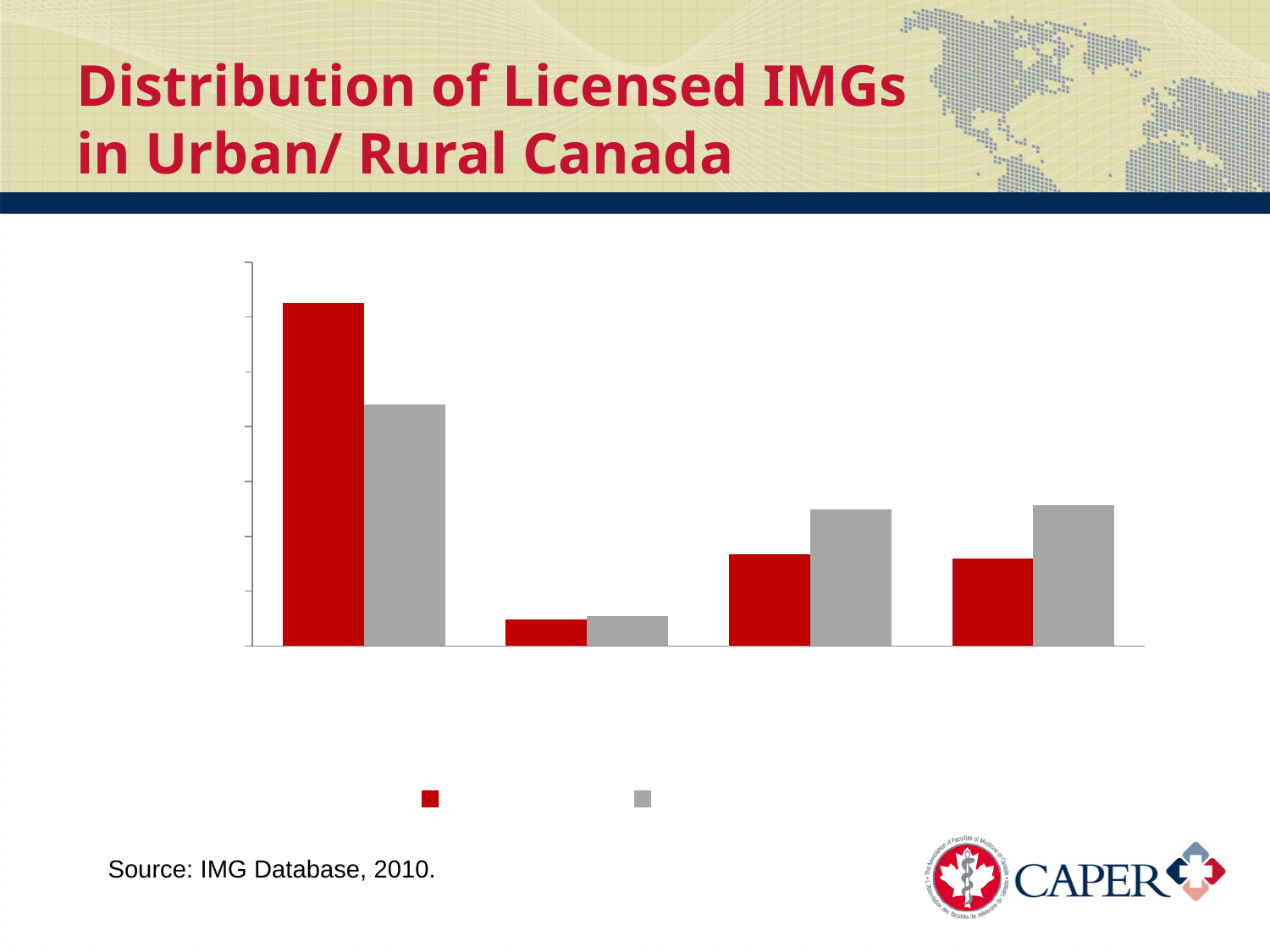
In the fourth (rightmost) group of bars, which is taller, the red bar or the grey bar? the grey bar What kind of chart is shown on the slide? bar chart In the third group of bars from the left, which is taller, the red bar or the grey bar? the grey bar In the first (leftmost) group of bars, which is taller, the red bar or the grey bar? the red bar Counting from the left, which group of bars contains the shortest bars in the chart? the second group Counting from the left, which group of bars contains the tallest bar in the chart? the first group How many groups of bars (categories) does the chart show? 4 How many series does the chart's legend list? 2 What two colours are used for the bars in the chart? red and grey What is the title of the slide containing the chart? Distribution of Licensed IMGs in Urban/ Rural Canada